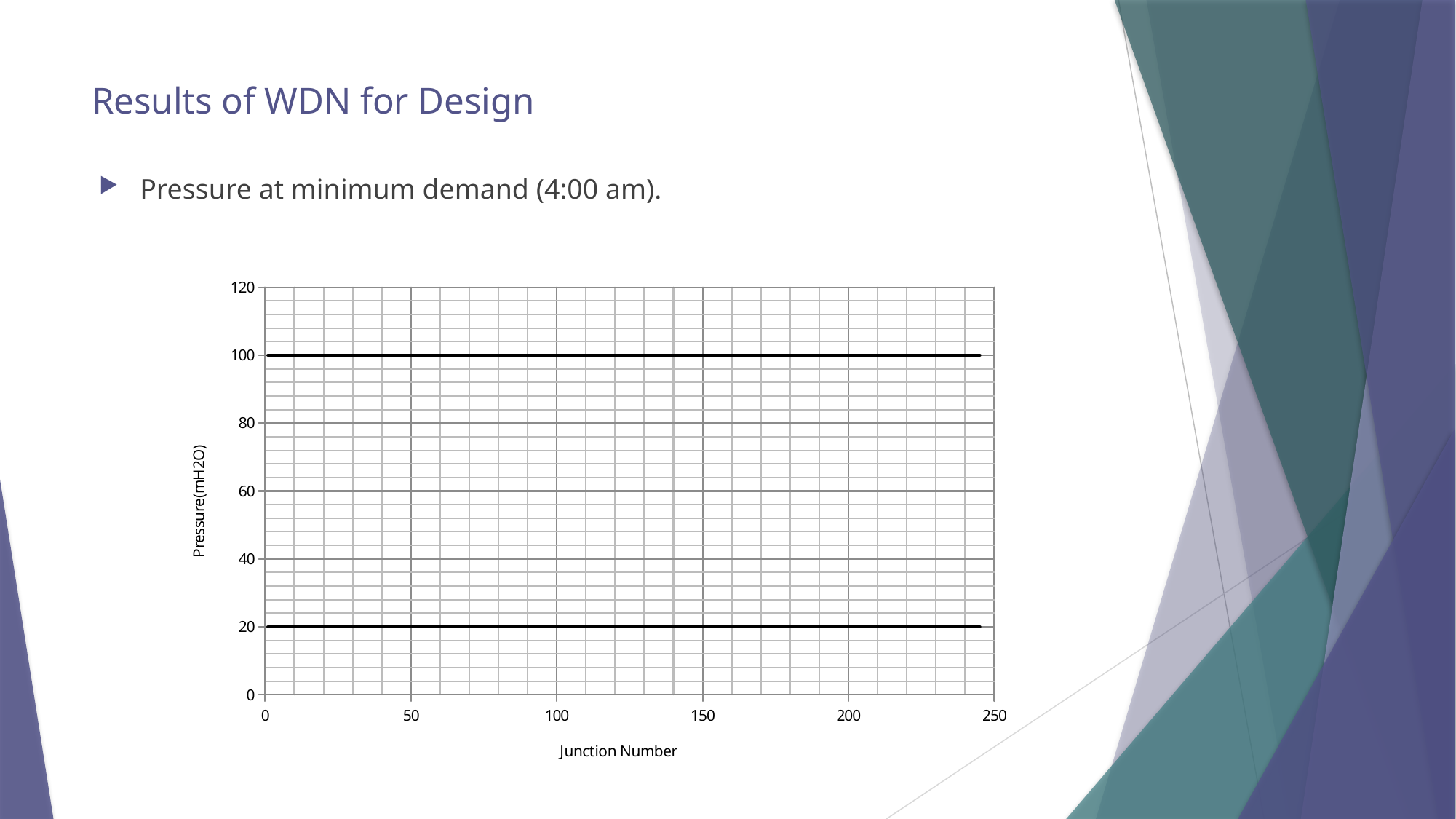
What kind of chart is shown on the slide? line chart At what pressure value does the upper line on the chart sit? 100 Which of the two plotted lines has the higher pressure value, the upper or the lower one? the upper one What is the maximum value shown on the vertical axis of the chart? 120 Do the plotted lines rise, fall, or stay constant as the junction number increases? stay constant Is the value of the upper line greater or less than 80? greater At what pressure value does the lower line on the chart sit? 20 How many horizontal lines are plotted on the chart? 2 Is the value of the lower line greater or less than 40? less What is the difference in pressure between the upper line and the lower line? 80 What is the label of the horizontal axis of the chart? Junction Number What is the label of the vertical axis of the chart? Pressure(mH2O)